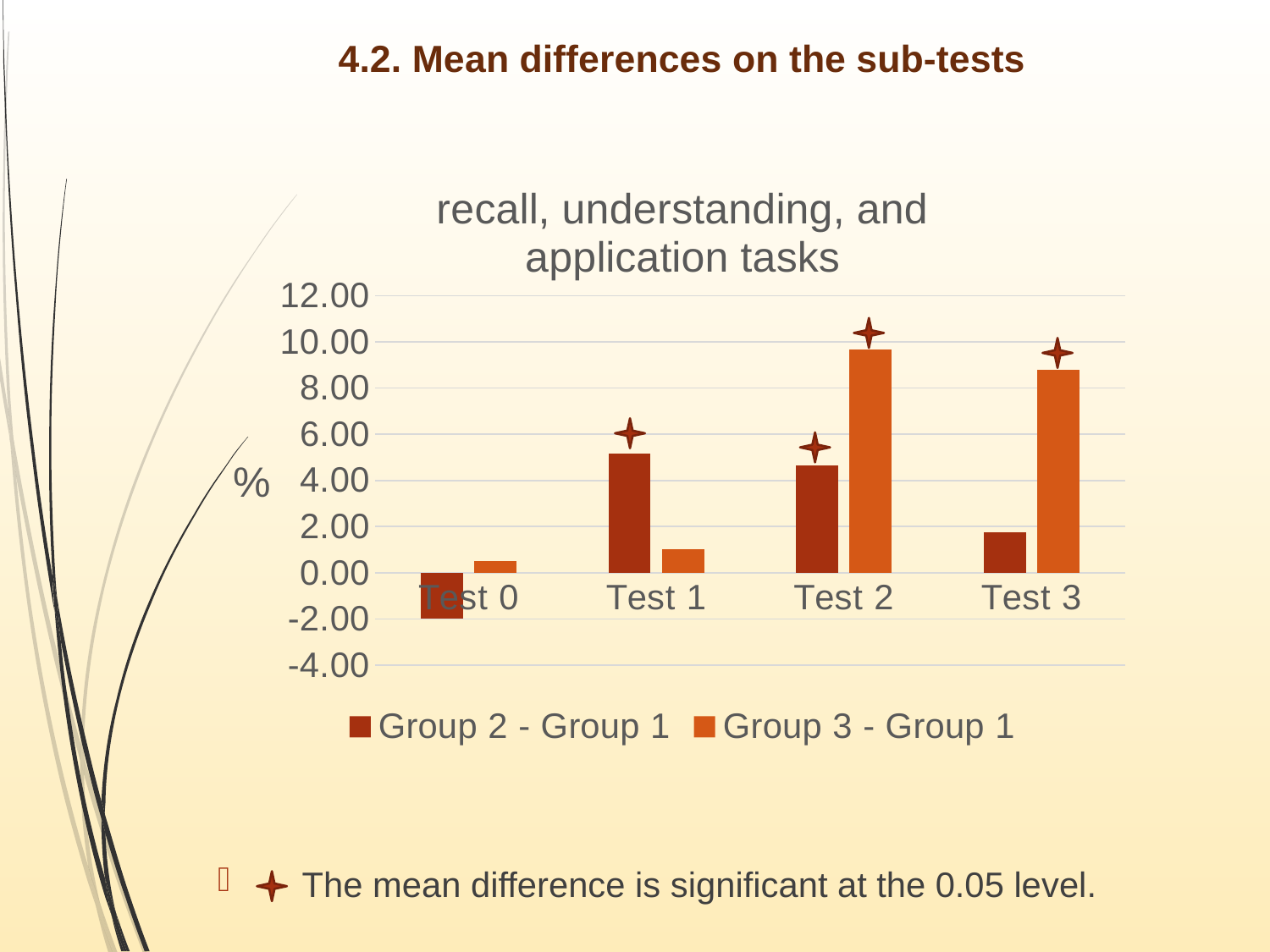
For Test 2, which is larger: Group 2 - Group 1 or Group 3 - Group 1? Group 3 - Group 1 What kind of chart is shown on the slide? Bar chart How many test categories are shown on the x axis? 4 For Test 1, which is larger: Group 2 - Group 1 or Group 3 - Group 1? Group 2 - Group 1 For which test is the Group 3 - Group 1 bar highest? Test 2 How many series does the legend list? 2 Is the Group 2 - Group 1 value for Test 1 greater or less than 4.00? greater Is the Group 2 - Group 1 value for Test 0 greater or less than 0.00? less Is the Group 3 - Group 1 value for Test 2 greater or less than 8.00? greater For which test is the Group 2 - Group 1 bar lowest? Test 0 What is the title of the chart? recall, understanding, and application tasks Which series is shown in the lighter orange colour? Group 3 - Group 1